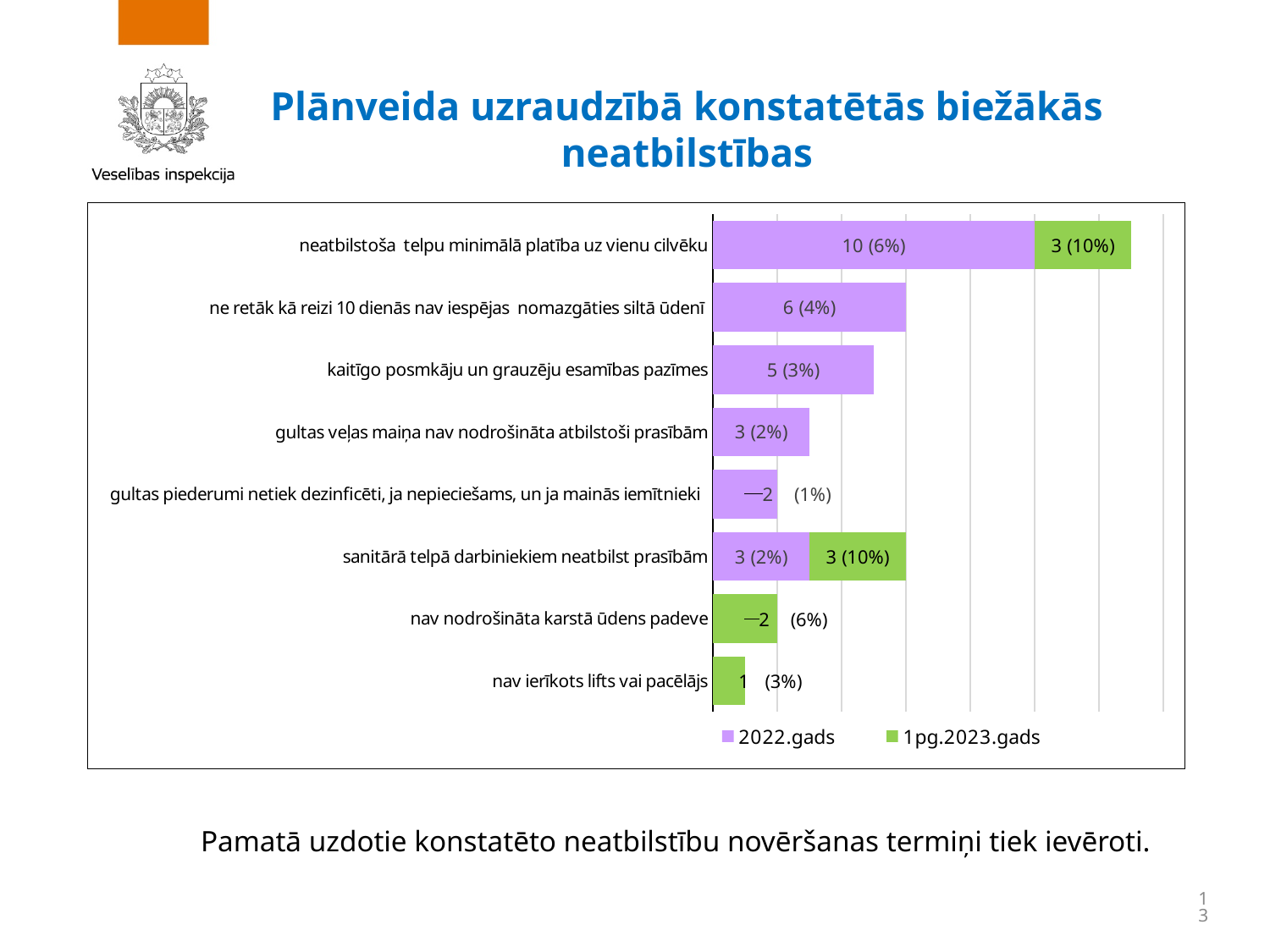
Which category has the highest 2022.gads value? neatbilstoša telpu minimālā platība uz vienu cilvēku What kind of chart is shown on the slide? bar chart How many categories are shown on the chart? 8 What is the total count for the stacked bar 'neatbilstoša telpu minimālā platība uz vienu cilvēku' (2022.gads plus 1pg.2023.gads)? 13 What is the 1pg.2023.gads data label for 'sanitārā telpā darbiniekiem neatbilst prasībām'? 3 (10%) What is the 2022.gads data label for 'neatbilstoša telpu minimālā platība uz vienu cilvēku'? 10 (6%) Which is larger for 2022.gads: 'ne retāk kā reizi 10 dienās nav iespējas nomazgāties siltā ūdenī' or 'kaitīgo posmkāju un grauzēju esamības pazīmes'? ne retāk kā reizi 10 dienās nav iespējas nomazgāties siltā ūdenī Which colour represents the 1pg.2023.gads series in the chart? green What is the 2022.gads data label for 'kaitīgo posmkāju un grauzēju esamības pazīmes'? 5 (3%) How many series does the legend list? 2 What is the 1pg.2023.gads data label for 'nav ierīkots lifts vai pacēlājs'? 1 (3%) What is the difference between the 2022.gads counts for 'ne retāk kā reizi 10 dienās nav iespējas nomazgāties siltā ūdenī' and 'gultas veļas maiņa nav nodrošināta atbilstoši prasībām'? 3